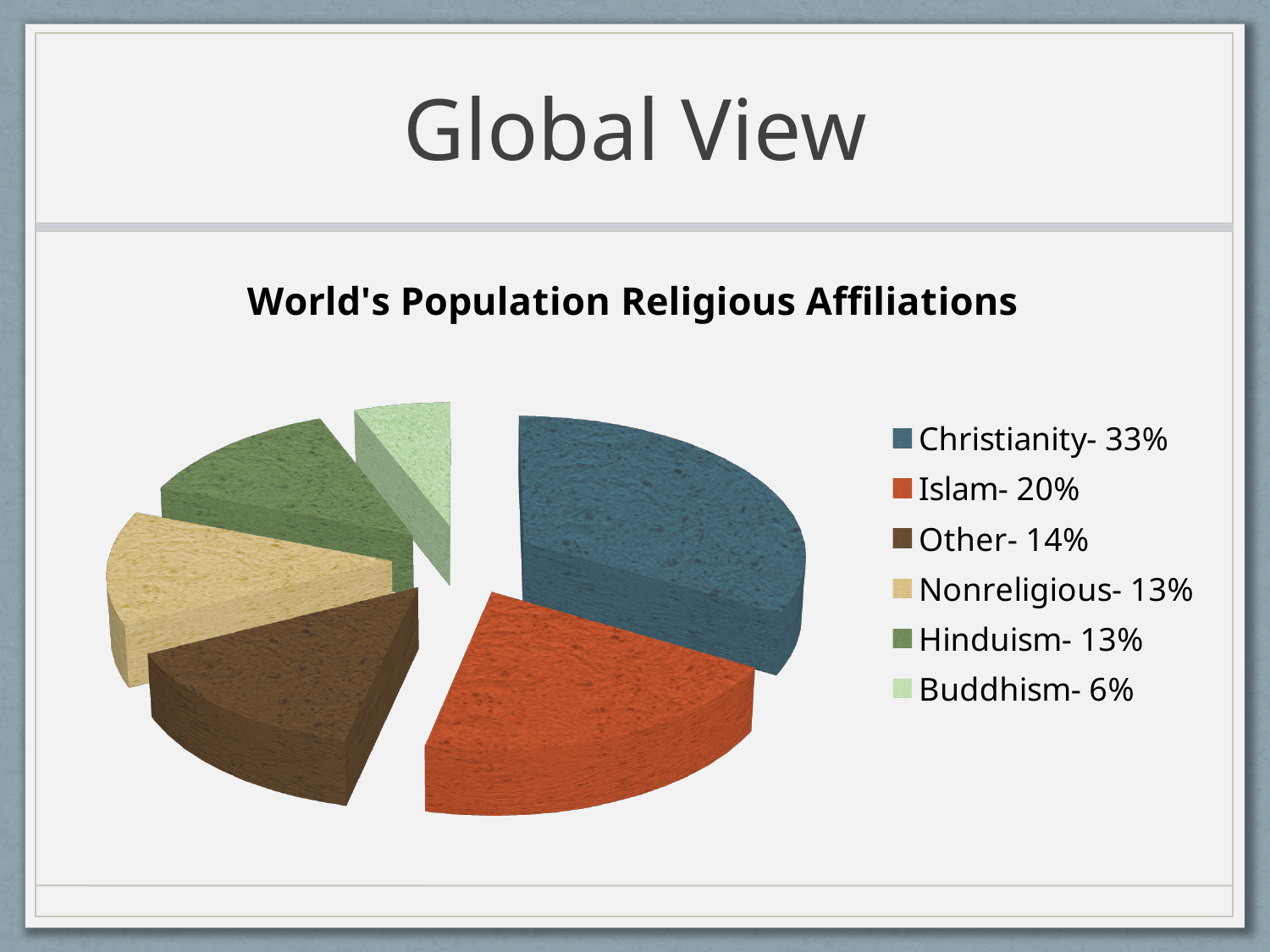
What is the title of the chart? World's Population Religious Affiliations Which has a larger share, Islam or Other? Islam What percentage is shown for Buddhism? 6% What percentage is shown for Islam? 20% What percentage of the world's population is shown for Christianity? 33% Which religious affiliation has the smallest share of the pie? Buddhism What kind of chart is shown on the slide? pie chart What percentage is shown for Nonreligious? 13% Which religious affiliation has the largest share of the pie? Christianity What is the difference in percentage points between Christianity and Islam? 13 How many slices does the pie chart have? 6 What colour is the slice for Islam? orange-red